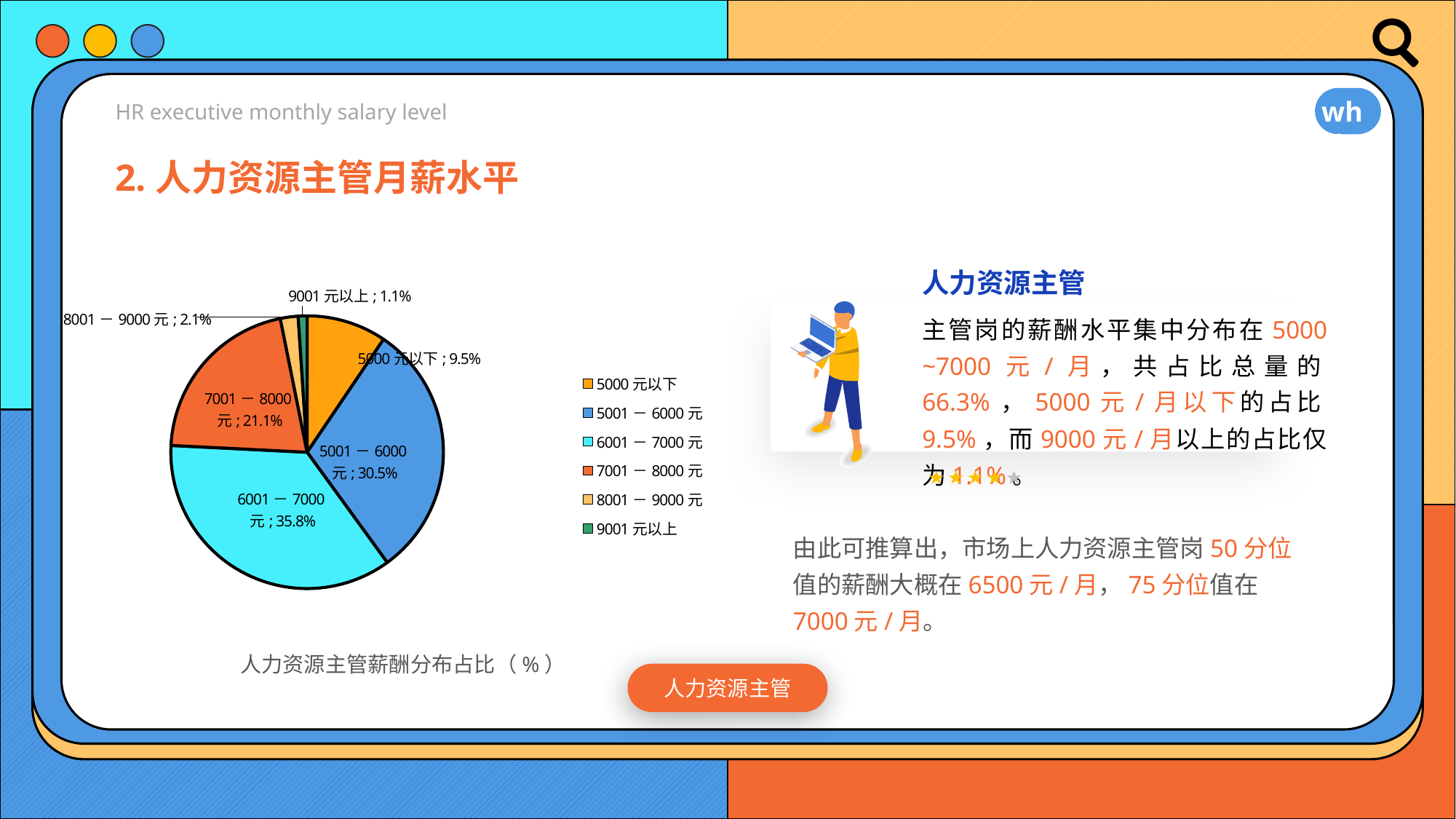
What is the value shown for the 5001－6000 元 slice? 30.5% What is the difference between the 6001－7000 元 share and the 5001－6000 元 share? 5.3% What type of chart is shown on the slide? pie chart What is the value for the 5000 元以下 slice? 9.5% What is the caption shown below the pie chart? 人力资源主管薪酬分布占比（%） Which is larger, the share for 7001－8000 元 or the share for 5000 元以下? 7001－8000 元 What share of the pie does the 6001－7000 元 slice represent? 35.8% Which salary range has the largest share of the pie? 6001－7000 元 What is the value for the 9001 元以上 slice? 1.1% How many slices does the pie chart have? 6 What percentage is labelled for the 7001－8000 元 slice? 21.1% Which salary range has the smallest share of the pie? 9001 元以上